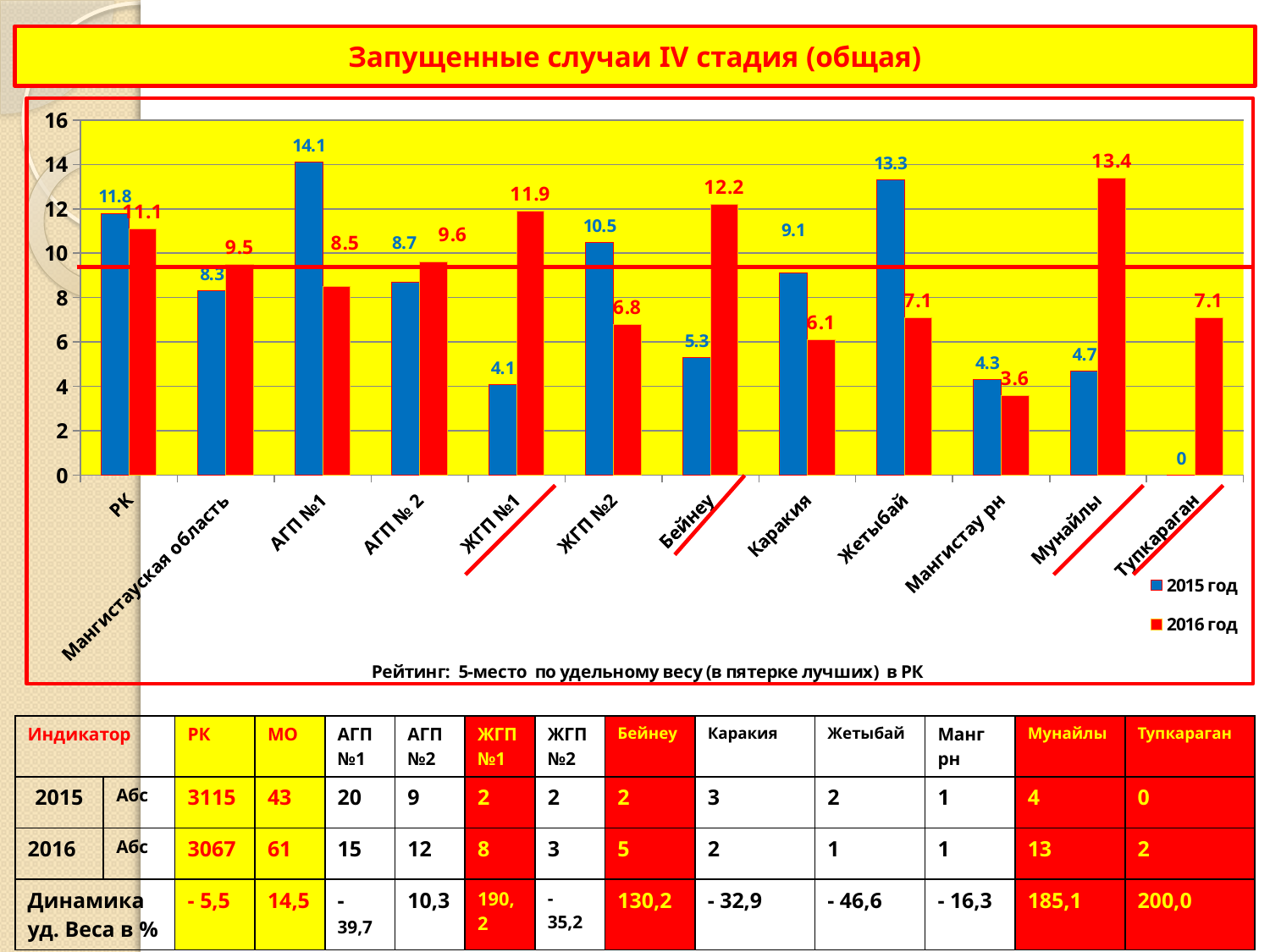
What type of chart is shown on the slide? bar chart Which category has the highest value in the 2016 год series? Мунайлы What is the value for Бейнеу in the 2016 год series? 12.2 How many series does the chart legend list? 2 What is the value for Тупкараган in the 2015 год series? 0 Which category has the highest value in the 2015 год series? АГП №1 How many categories are shown on the x axis of the chart? 12 What is the value for АГП №1 in the 2015 год series? 14.1 What is the title of the chart? Запущенные случаи IV стадия (общая) What is the difference between the 2016 год and 2015 год values for Мунайлы? 8.7 For Жетыбай, which series has the larger value, 2015 год or 2016 год? 2015 год Which category has the lowest value in the 2016 год series? Мангистау рн